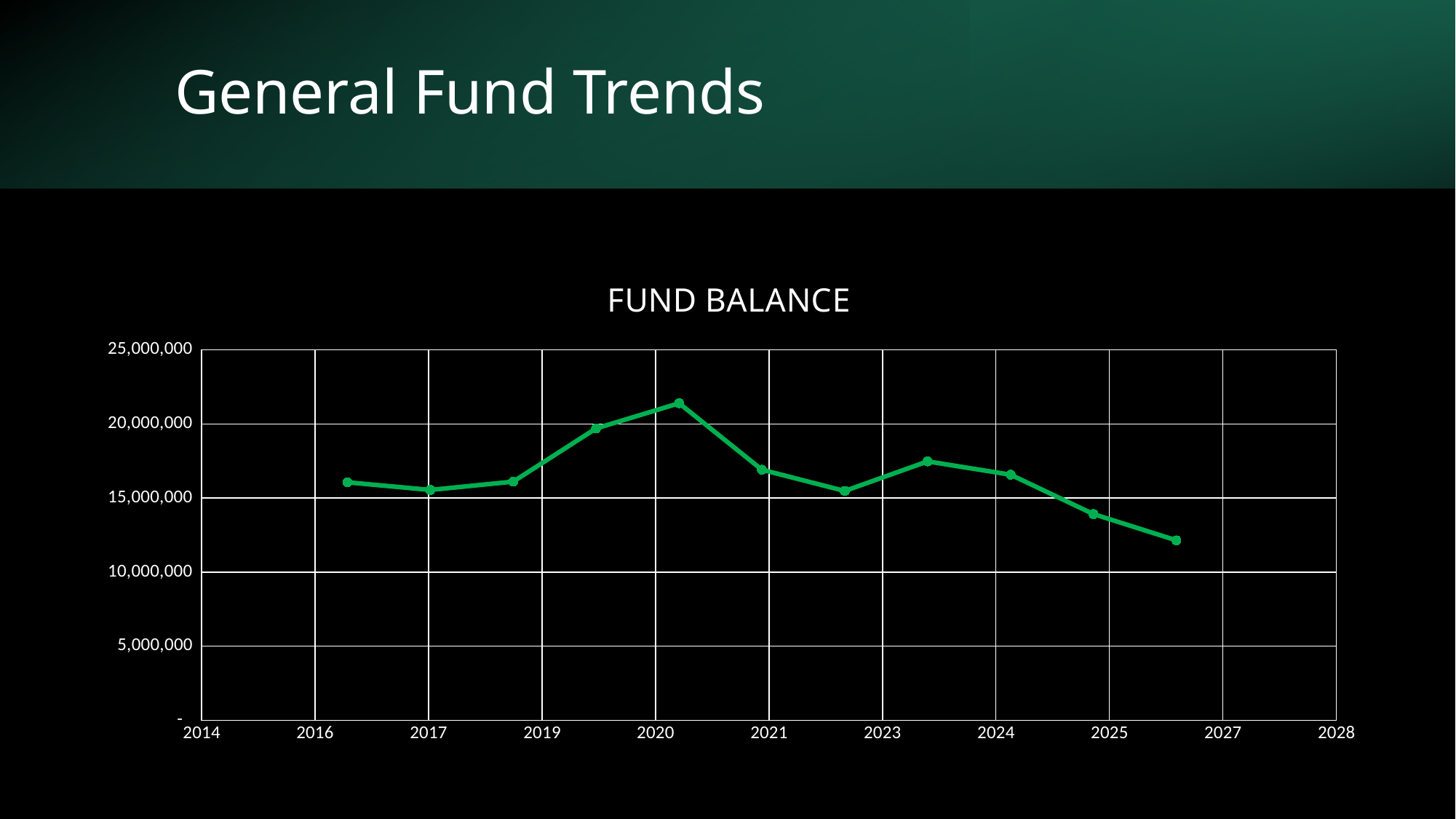
Is the highest point on the line greater or less than 20,000,000? greater What is the title of the chart? FUND BALANCE Is the lowest point on the line greater or less than 10,000,000? greater What is the highest value shown on the vertical axis? 25,000,000 Does the fund balance rise or fall from its peak to the end of the line? fall Is the first (leftmost) point on the line greater or less than 15,000,000? greater How many data points are plotted on the line? 11 Near which year label does the line reach its highest value? 2020 Is the last point on the line higher or lower than the first point? lower What kind of chart is shown on the slide? line chart